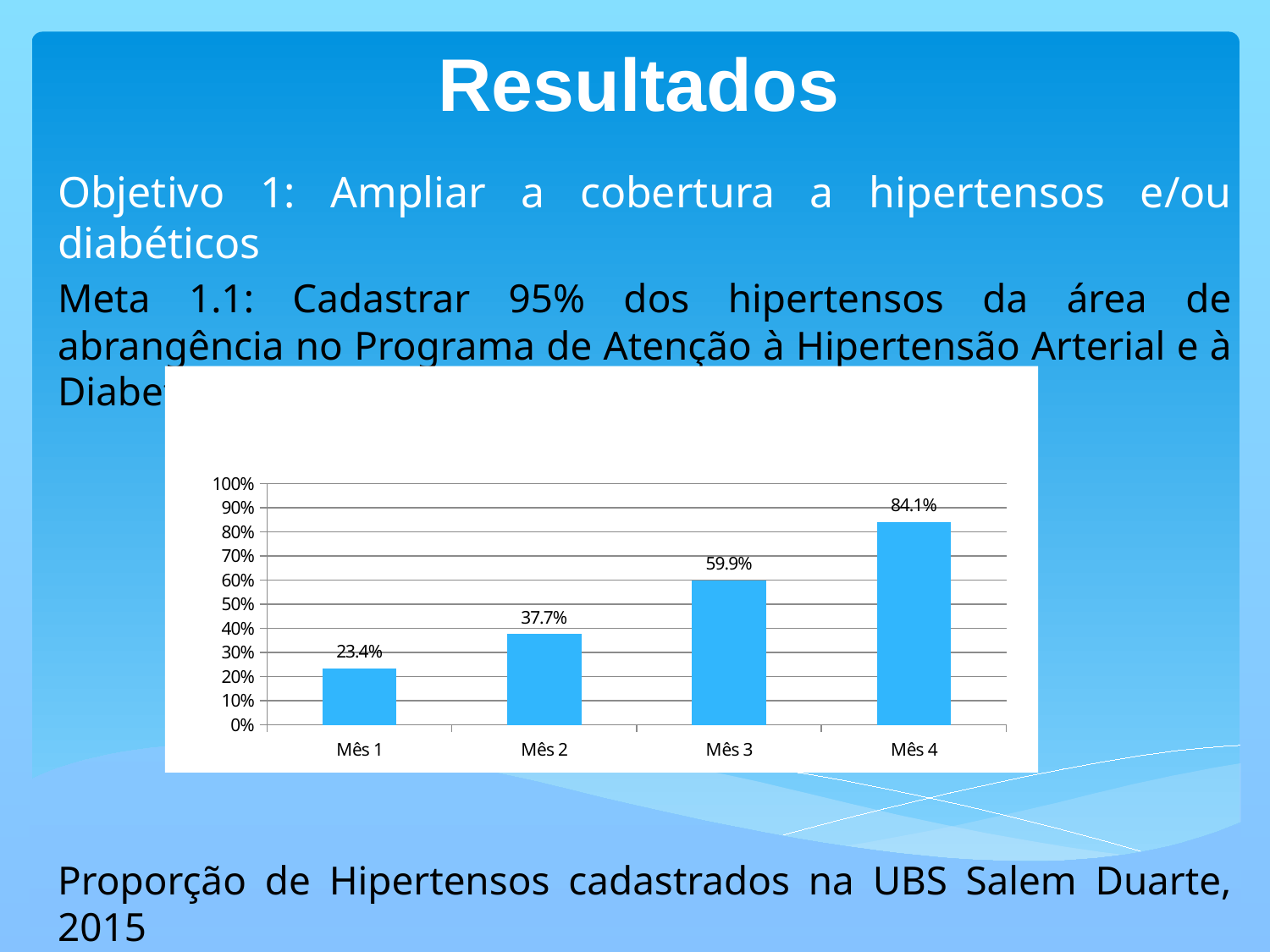
What is the difference between the values for Mês 2 and Mês 1? 14.3% What is the value for Mês 4? 84.1% What is the value for Mês 1? 23.4% What is the value for Mês 2? 37.7% Which month has the highest value? Mês 4 How many months are shown on the x axis? 4 Do the values rise or fall from Mês 1 to Mês 4? Rise What is the value for Mês 3? 59.9% Which month has the lowest value? Mês 1 What kind of chart is shown on the slide? Bar chart What is the difference between the values for Mês 4 and Mês 3? 24.2% Which is larger, the value for Mês 2 or the value for Mês 3? Mês 3